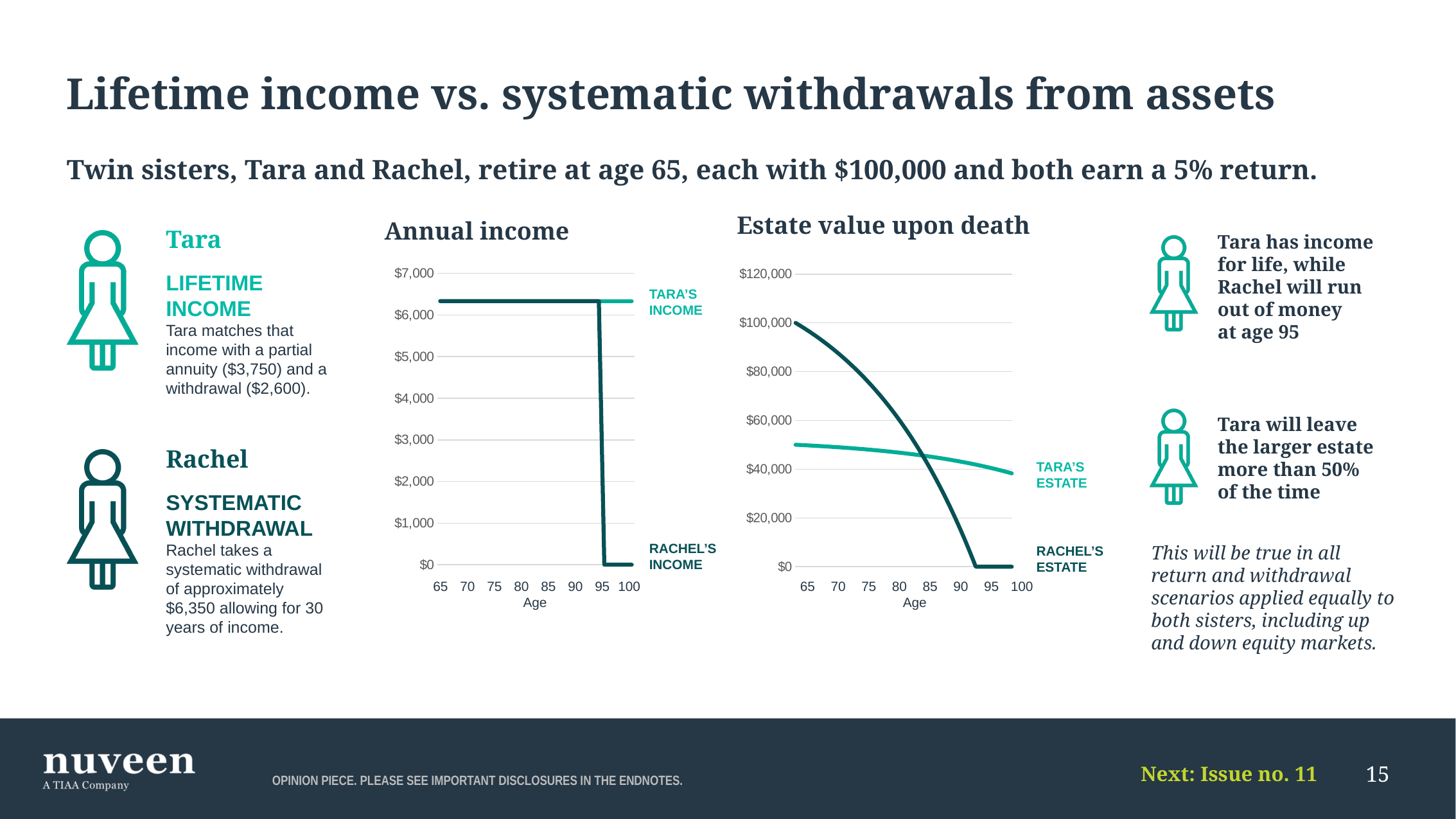
In the "Estate value upon death" chart, what is Rachel's estate value at age 100? $0 In the "Estate value upon death" chart, is Tara's estate at age 65 greater or less than $60,000? less In the "Annual income" chart, how many series are plotted? 2 In the "Estate value upon death" chart, which is larger at age 70: Tara's estate or Rachel's estate? Rachel's estate What kind of chart is the "Estate value upon death" chart? line chart In the "Annual income" chart, is Tara's income at age 80 greater or less than $6,000? greater In the "Estate value upon death" chart, is Tara's estate at age 100 greater or less than $20,000? greater In the "Estate value upon death" chart, does Rachel's estate rise or fall as age increases? fall What kind of chart is the "Annual income" chart? line chart In the "Estate value upon death" chart, what is Rachel's estate value at age 65? $100,000 What is the label of the x axis on the "Annual income" chart? Age In the "Annual income" chart, what is Rachel's income at age 100? $0